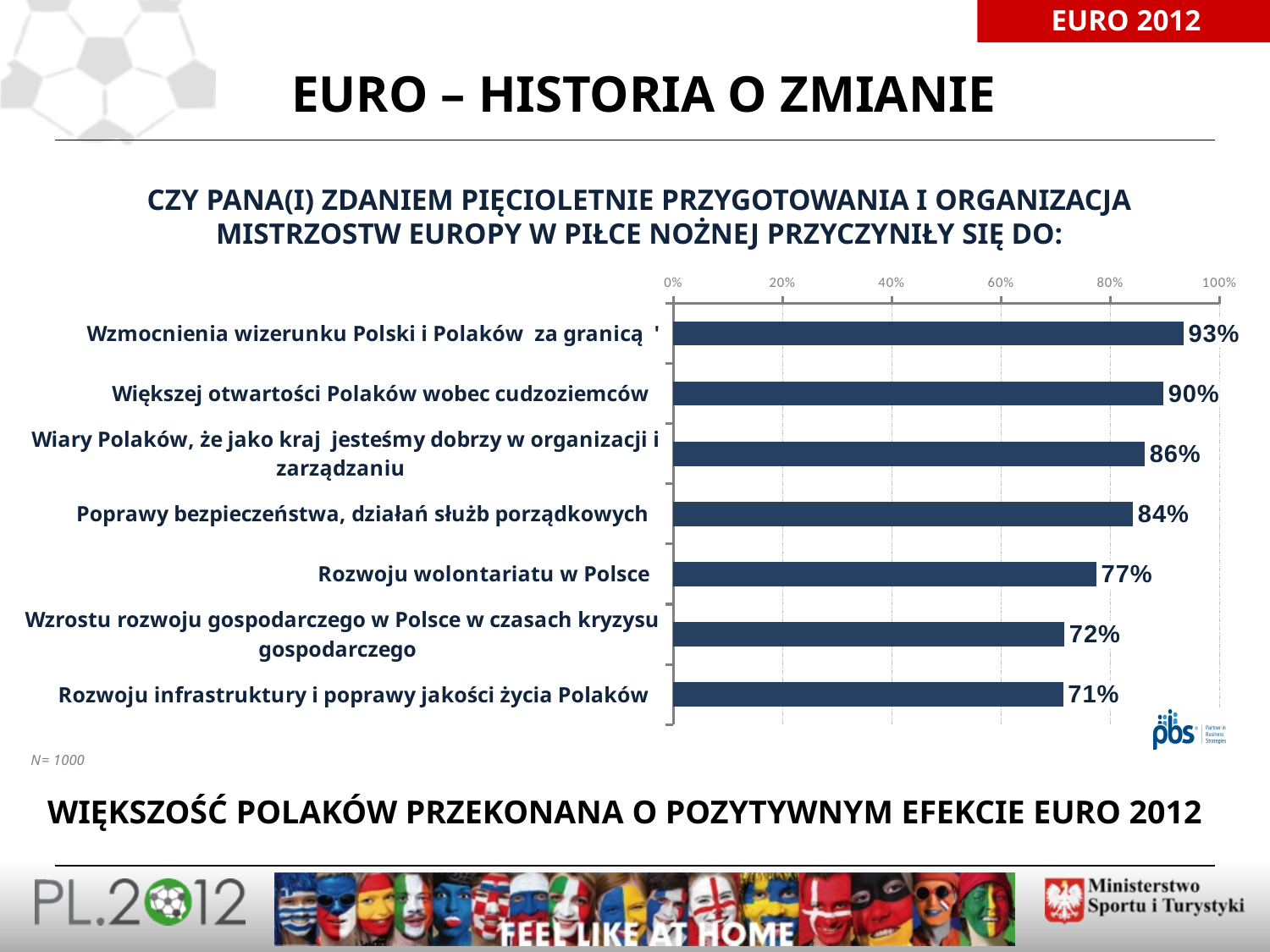
What sample size (N) is stated below the chart? N= 1000 How many categories are shown on the chart? 7 What is the value shown for "Rozwoju infrastruktury i poprawy jakości życia Polaków"? 71% What is the difference between the values for "Większej otwartości Polaków wobec cudzoziemców" and "Poprawy bezpieczeństwa, działań służb porządkowych"? 6% Which category has the lowest value on the chart? Rozwoju infrastruktury i poprawy jakości życia Polaków Which category has the highest value on the chart? Wzmocnienia wizerunku Polski i Polaków za granicą Do the values rise or fall going from the top bar to the bottom bar? fall Which is larger: the value for "Wiary Polaków, że jako kraj jesteśmy dobrzy w organizacji i zarządzaniu" or the value for "Wzrostu rozwoju gospodarczego w Polsce w czasach kryzysu gospodarczego"? Wiary Polaków, że jako kraj jesteśmy dobrzy w organizacji i zarządzaniu Is the value for "Rozwoju wolontariatu w Polsce" greater or less than 80%? less What kind of chart is shown on the slide? bar chart What is the value shown for "Rozwoju wolontariatu w Polsce"? 77% What percentage of respondents said the Euro preparations contributed to "Wzmocnienia wizerunku Polski i Polaków za granicą"? 93%